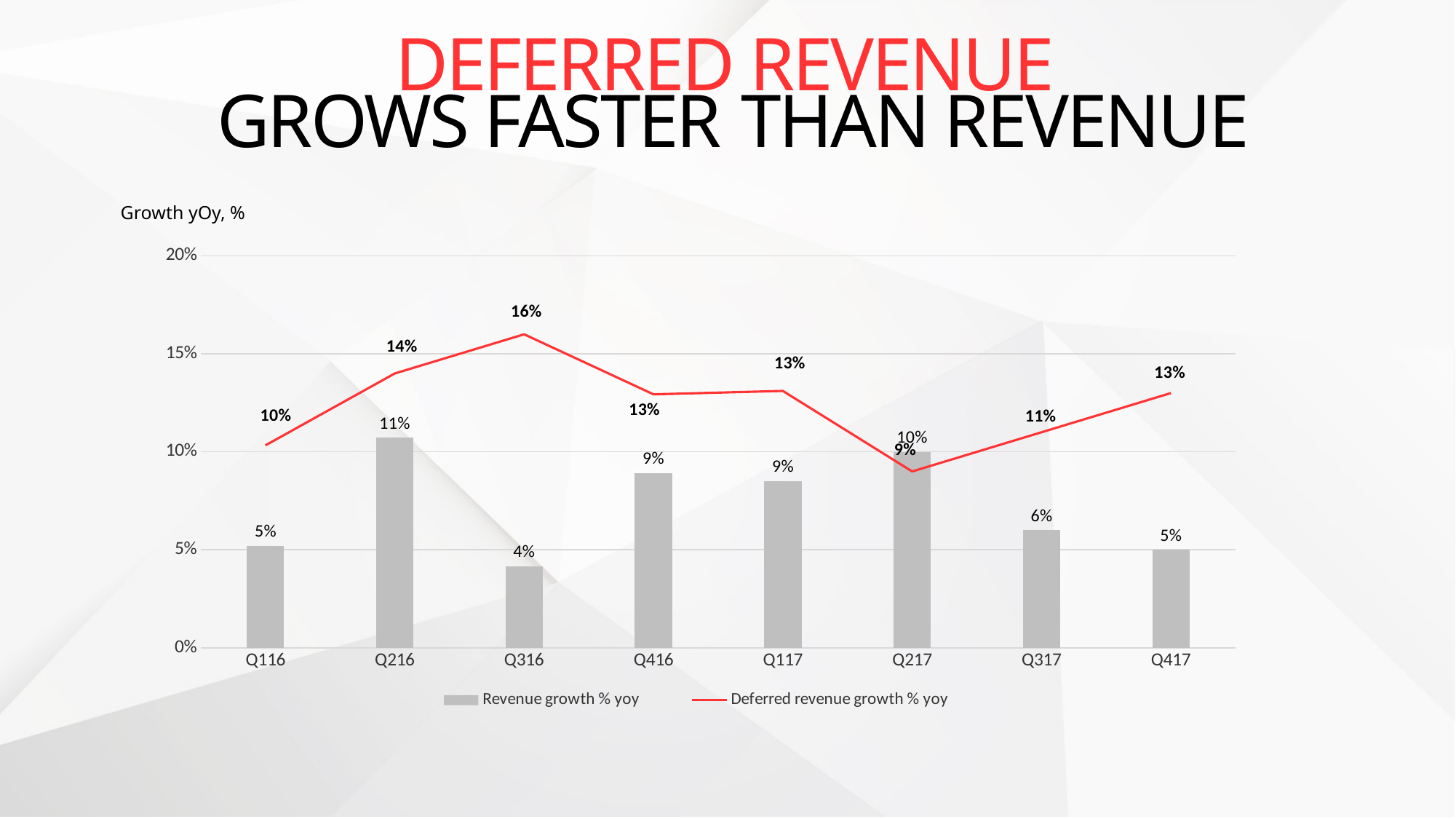
What is the Deferred revenue growth % yoy for Q116? 10% In Q217, which is larger: Revenue growth % yoy or Deferred revenue growth % yoy? Revenue growth % yoy Does Deferred revenue growth % yoy rise or fall from Q316 to Q217? Fall What kind of chart is shown on the slide? Combined bar and line chart What is the Revenue growth % yoy for Q417? 5% What is the Revenue growth % yoy for Q216? 11% How many series does the legend list? 2 What is the Deferred revenue growth % yoy for Q316? 16% In which quarter is Revenue growth % yoy lowest? Q316 In which quarter is Deferred revenue growth % yoy highest? Q316 What is the difference between Deferred revenue growth % yoy and Revenue growth % yoy in Q316? 12% How many quarters are shown on the x axis? 8